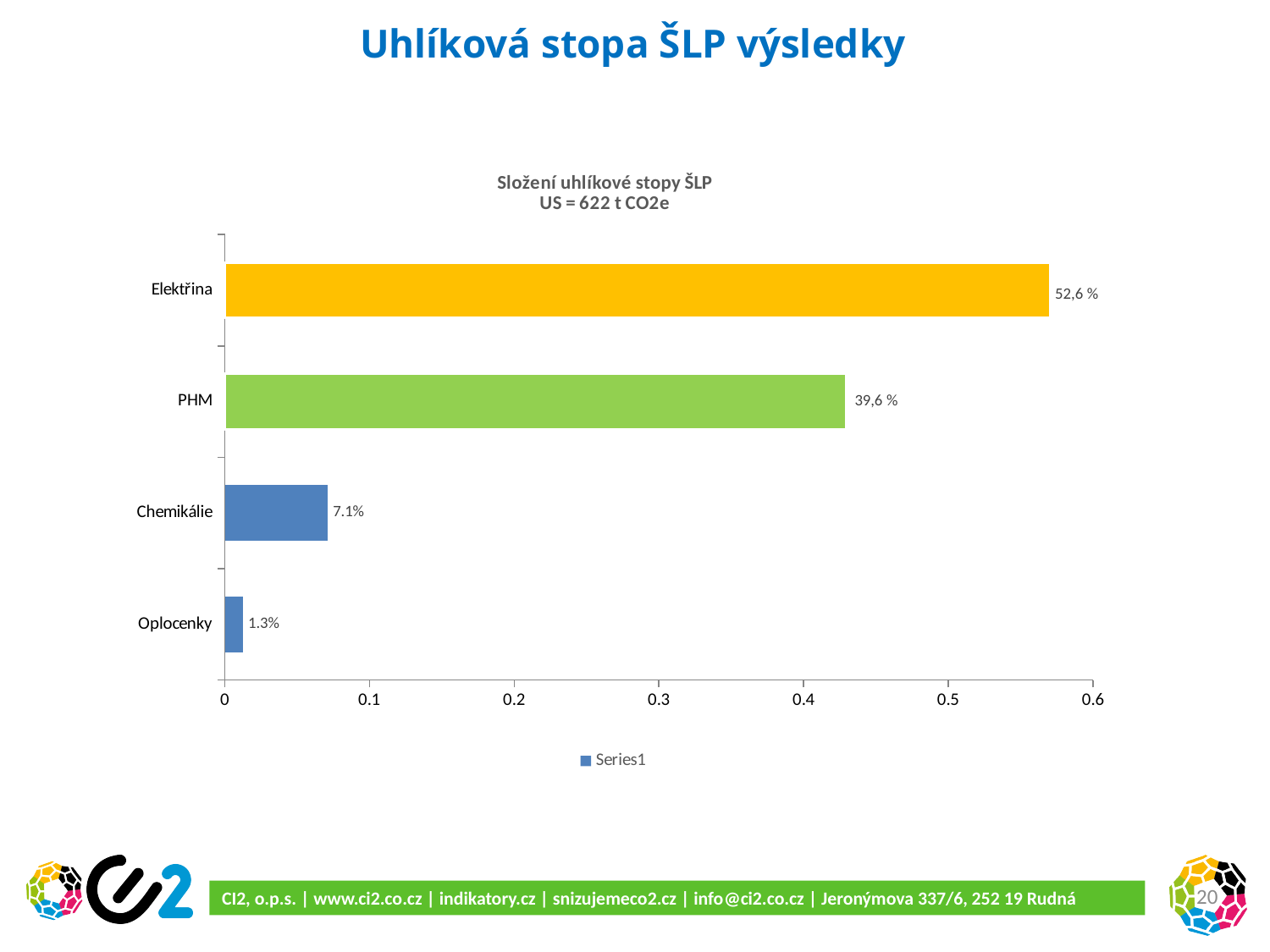
What is the data label shown for Elektřina? 52,6 % What is the title of the chart? Složení uhlíkové stopy ŠLP US = 622 t CO2e What is the data label shown for Chemikálie? 7.1% Which is larger, the value for PHM or the value for Chemikálie? PHM How many categories are shown in the chart? 4 What type of chart is shown on the slide? Bar chart Which category has the highest value? Elektřina Is the bar for Elektřina greater or less than 0.5 on the axis? greater What is the data label shown for Oplocenky? 1.3% Which category has the lowest value? Oplocenky What is the data label shown for PHM? 39,6 % Is the bar for PHM greater or less than 0.5 on the axis? less